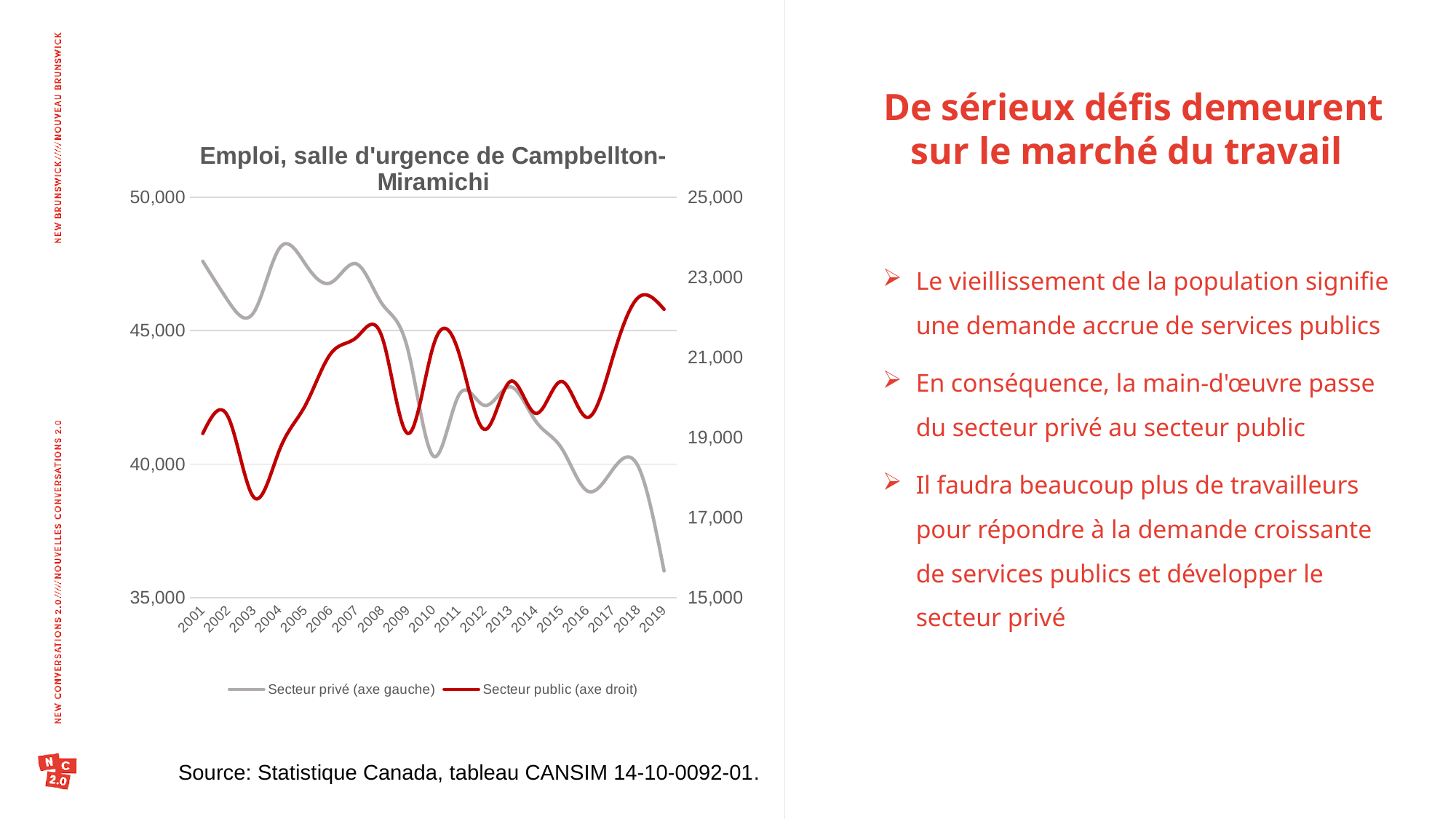
What kind of chart is shown on the slide? line chart In which year is the Secteur privé series at its lowest? 2019 How many series does the legend list? 2 How many years are plotted along the x axis? 19 What is the title of the chart? Emploi, salle d'urgence de Campbellton-Miramichi In which year is the Secteur public series at its highest? 2018 Which is larger for the Secteur public series: the value in 2003 or the value in 2018? 2018 In which year is the Secteur public series at its lowest? 2003 Is the Secteur public value for 2018 greater or less than 21,000? greater Which series is plotted against the right axis according to the legend? Secteur public (axe droit) Is the Secteur privé value for 2019 greater or less than 40,000? less Overall, does the Secteur privé series rise or fall from 2001 to 2019? fall